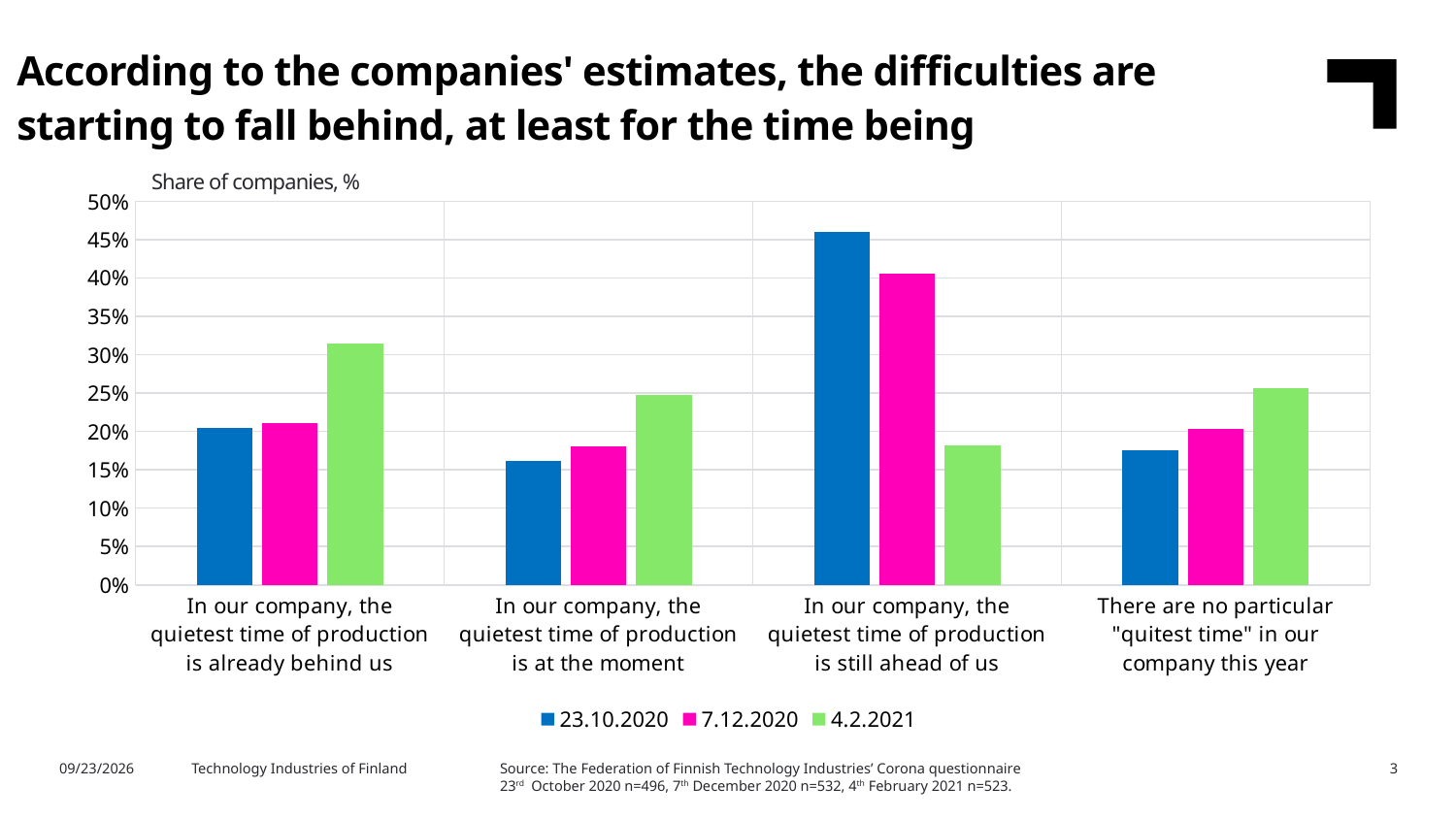
Is the 7.12.2020 value for "In our company, the quietest time of production is at the moment" greater or less than 20%? less What kind of chart is shown on the slide? bar chart What label is shown above the vertical axis of the chart? Share of companies, % How many categories are shown on the x axis? 4 For "In our company, the quietest time of production is already behind us", which is larger: the 23.10.2020 value or the 4.2.2021 value? 4.2.2021 For "There are no particular "quitest time" in our company this year", do the values rise or fall from 23.10.2020 to 4.2.2021? rise Is the 23.10.2020 value for "In our company, the quietest time of production is still ahead of us" greater or less than 40%? greater For "In our company, the quietest time of production is still ahead of us", do the values rise or fall from 23.10.2020 to 4.2.2021? fall For the 23.10.2020 series, which category has the highest value? In our company, the quietest time of production is still ahead of us For the 4.2.2021 series, which category has the lowest value? In our company, the quietest time of production is still ahead of us How many series does the legend list? 3 Is the 4.2.2021 value for "In our company, the quietest time of production is still ahead of us" greater or less than 20%? less